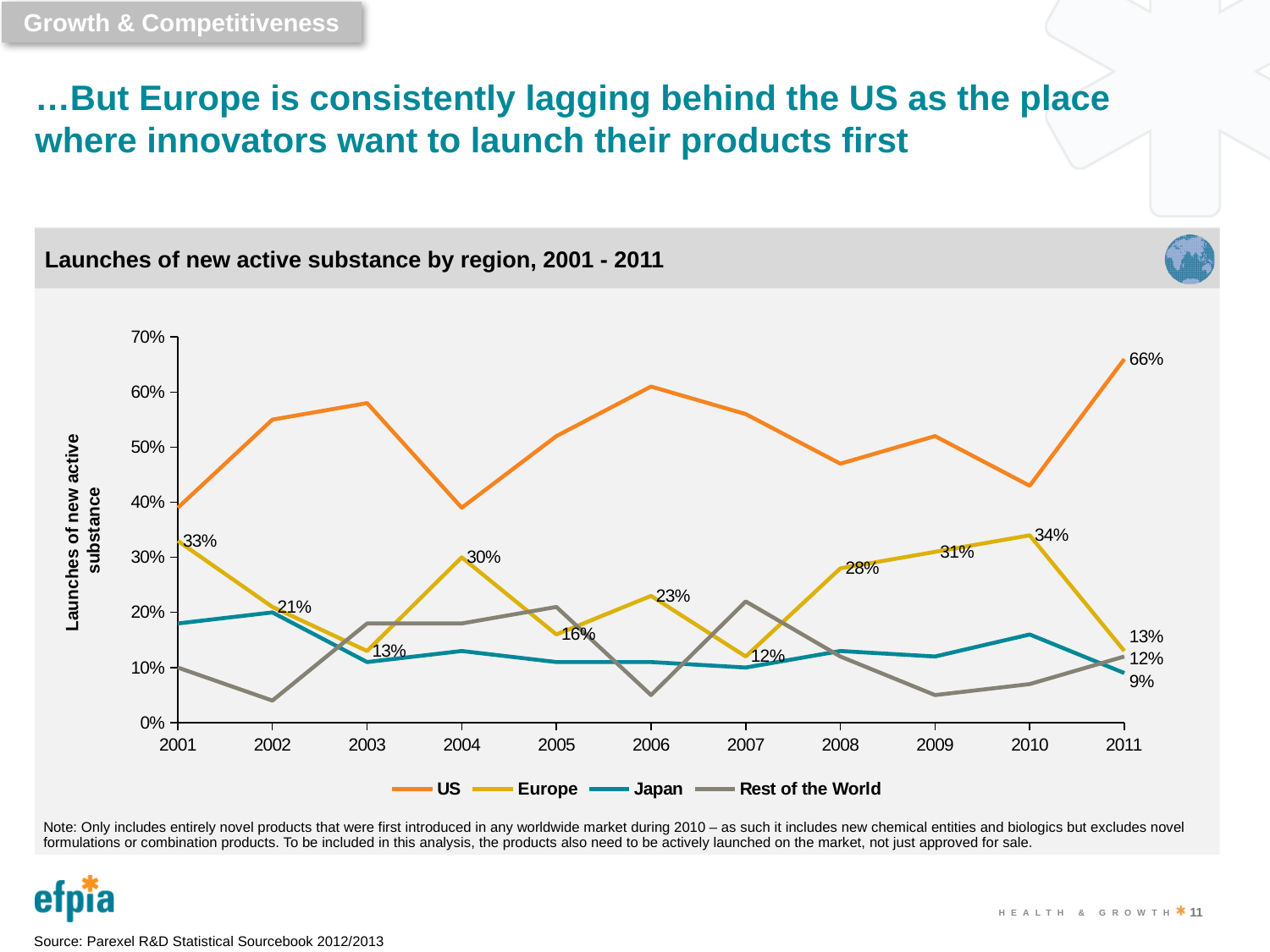
What is the difference between Europe's value in 2010 and its value in 2011? 21% Is the value for the US in 2004 greater or less than 30%? greater What is the title of the chart? Launches of new active substance by region, 2001 - 2011 How many years are plotted along the x axis? 11 What is the value for Europe in 2001? 33% In which year does Europe reach its highest labelled value? 2010 What is the value for the US in 2011? 66% What type of chart is shown on the slide? line chart How many series does the legend list? 4 What is the value for Europe in 2010? 34% What is the value for Japan in 2011? 9% Which series has the higher value in 2011, the US or Europe? US